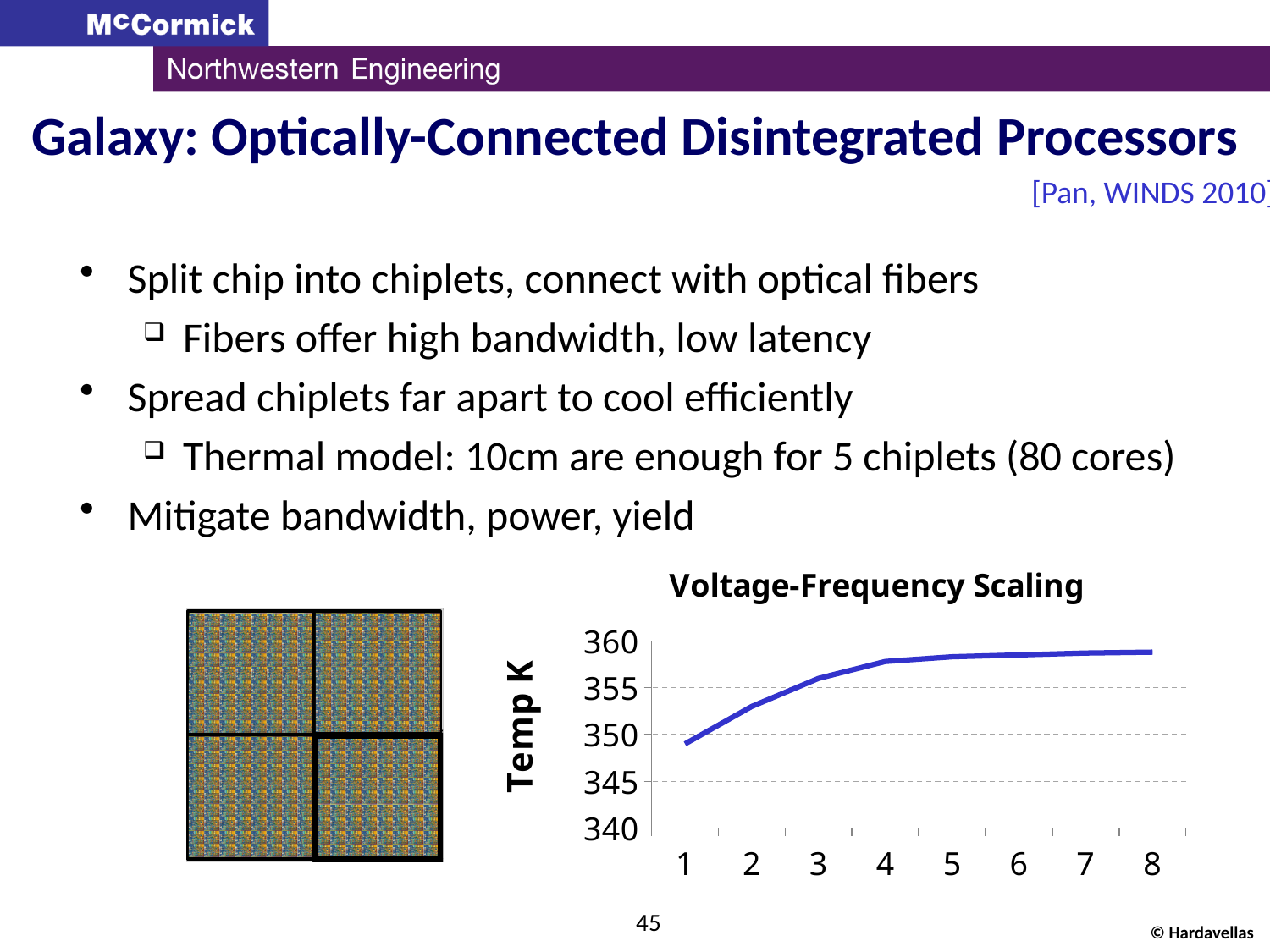
In the Voltage-Frequency Scaling chart, is the value at x = 2 greater or less than 350? greater In the Voltage-Frequency Scaling chart, which has the higher value, x = 2 or x = 4? 4 In the Voltage-Frequency Scaling chart, is the value at x = 4 greater or less than 355? greater In the Voltage-Frequency Scaling chart, which x value has the lowest temperature? 1 How many points are plotted along the x axis of the Voltage-Frequency Scaling chart? 8 What is the label on the y axis of the Voltage-Frequency Scaling chart? Temp K In the Voltage-Frequency Scaling chart, is the value at x = 1 greater or less than 350? less What kind of chart is the Voltage-Frequency Scaling chart? line chart In the Voltage-Frequency Scaling chart, which has the higher value, x = 1 or x = 8? 8 What is the title of the chart on the slide? Voltage-Frequency Scaling Do the values in the Voltage-Frequency Scaling chart rise or fall as the x axis goes from 1 to 8? rise